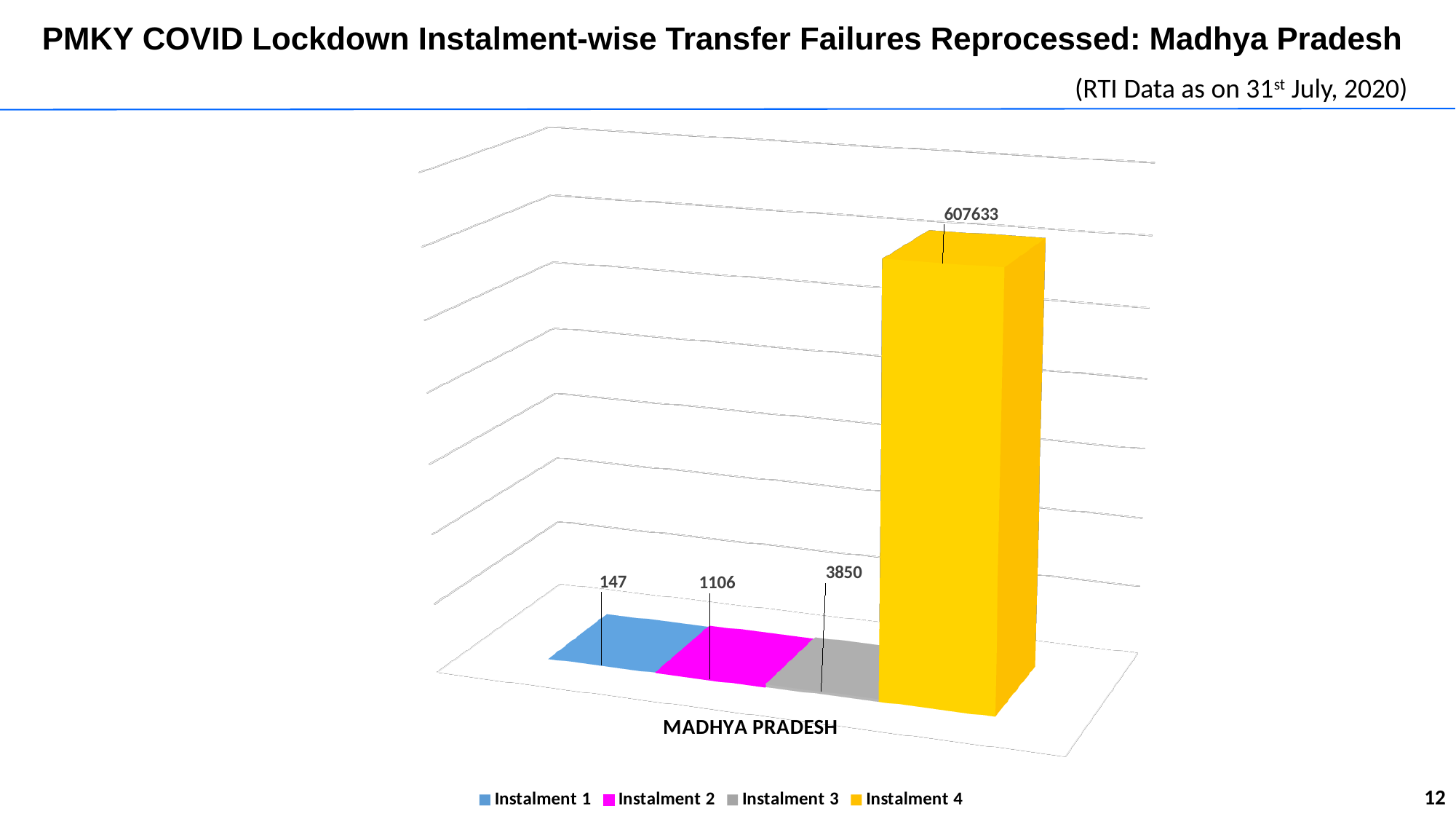
Which is larger, the value for Instalment 2 or Instalment 3? Instalment 3 What is the value for Instalment 1 for Madhya Pradesh? 147 How many series does the legend list? 4 What kind of chart is shown on the slide? Bar chart Which instalment has the highest value? Instalment 4 What is the value for Instalment 2 for Madhya Pradesh? 1106 What colour is the bar for Instalment 4? Yellow What is the difference between the values for Instalment 3 and Instalment 2? 2744 Do the values rise or fall from Instalment 1 to Instalment 4? Rise What is the value for Instalment 4 for Madhya Pradesh? 607633 Which instalment has the lowest value? Instalment 1 What is the value for Instalment 3 for Madhya Pradesh? 3850